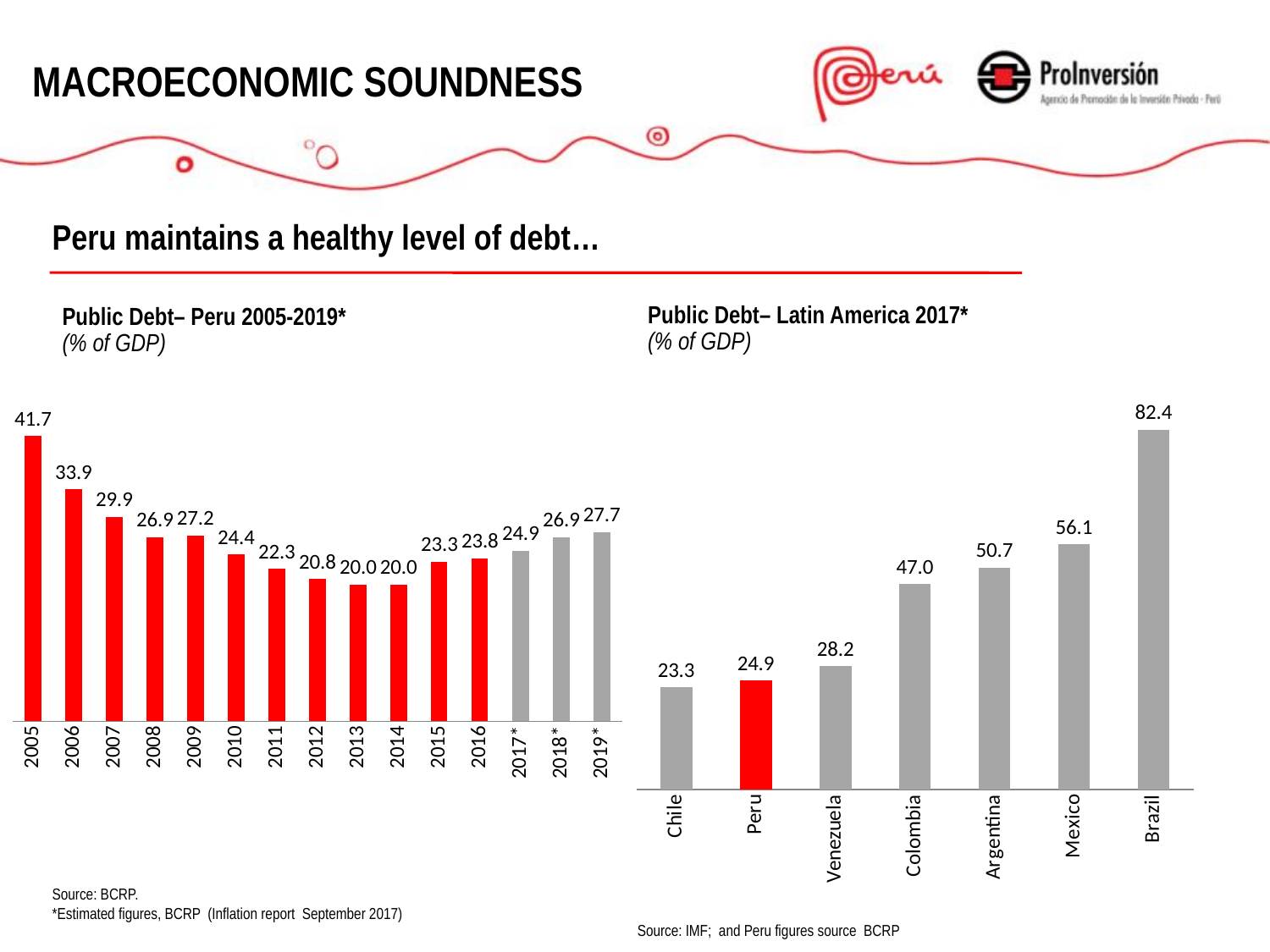
In the 'Public Debt– Peru 2005-2019*' chart, what is the value for 2016? 23.8 What kind of chart is the 'Public Debt– Latin America 2017*' chart? bar chart In the 'Public Debt– Latin America 2017*' chart, what is the value for Colombia? 47.0 In the 'Public Debt– Latin America 2017*' chart, what is the difference between the values for Brazil and Peru? 57.5 In the 'Public Debt– Peru 2005-2019*' chart, which year has the highest value? 2005 In the 'Public Debt– Peru 2005-2019*' chart, do the values rise or fall from 2005 to 2013? fall In the 'Public Debt– Latin America 2017*' chart, which country has the lowest value? Chile In the 'Public Debt– Latin America 2017*' chart, which country has the highest value? Brazil In the 'Public Debt– Peru 2005-2019*' chart, how many years are shown on the x axis? 15 In the 'Public Debt– Peru 2005-2019*' chart, what is the difference between the values for 2005 and 2019*? 14.0 In the 'Public Debt– Latin America 2017*' chart, which is larger, the value for Mexico or the value for Argentina? Mexico In the 'Public Debt– Peru 2005-2019*' chart, what is the value for 2005? 41.7